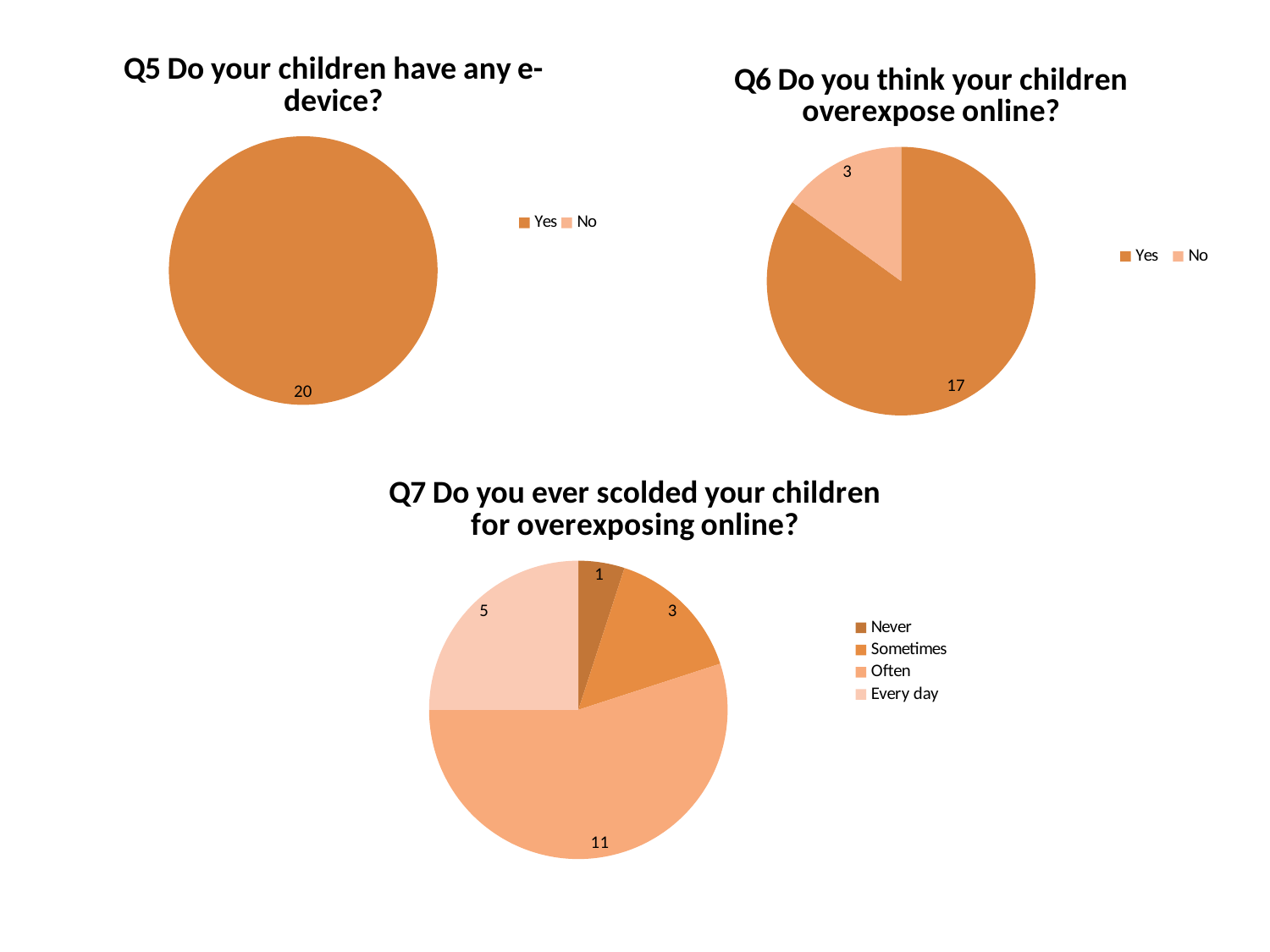
In the Q6 chart, how many respondents answered Yes? 17 In the Q6 chart, how many respondents answered No? 3 In the Q7 chart, which category has the largest slice? Often In the Q6 chart, what is the difference between the Yes and No counts? 14 In the Q7 chart, which category has the smallest slice? Never What type of chart is used for Q6? Pie chart In the Q7 chart, what share of the total does Often represent? 55% In the Q5 chart, what value is shown for Yes? 20 How many categories does the Q7 chart's legend list? 4 In the Q6 chart, what share of the total does No represent? 15% In the Q7 chart, how many respondents answered Often? 11 In the Q7 chart, which is larger, Every day or Sometimes? Every day